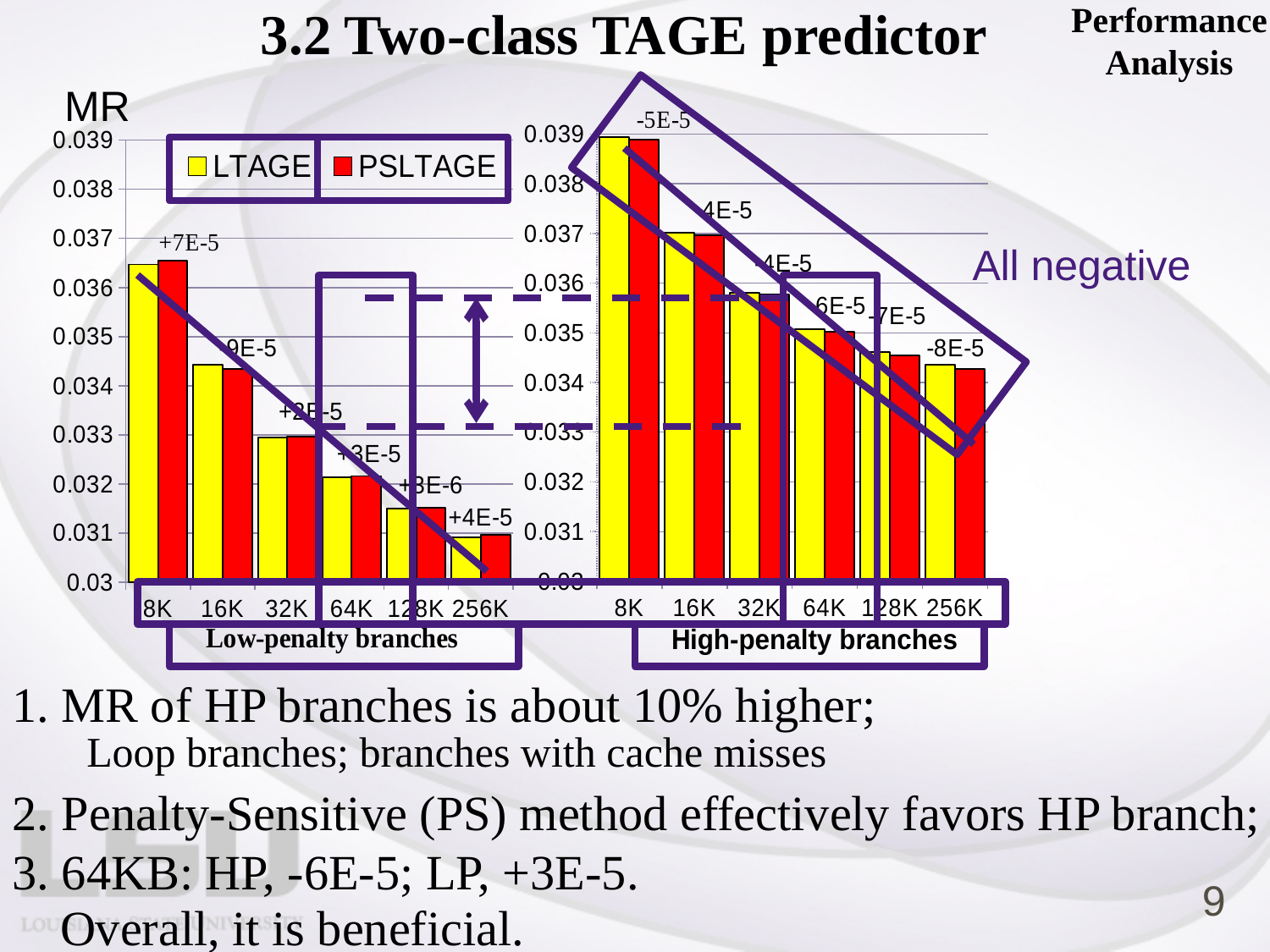
What kind of chart is used for the Low-penalty branches data? bar chart How many series does the legend list? 2 How many predictor size categories are shown on the x axis of the High-penalty branches chart? 6 Which two series are listed in the legend? LTAGE and PSLTAGE In the Low-penalty branches chart, is the LTAGE value for 256K greater or less than 0.031? less In the High-penalty branches chart, which predictor size has the highest MR? 8K In the High-penalty branches chart, do the MR values rise or fall as the predictor size increases from 8K to 256K? fall In the Low-penalty branches chart, which predictor size has the lowest MR? 256K In the High-penalty branches chart, is the LTAGE value for 8K greater or less than 0.038? greater In the Low-penalty branches chart, which predictor size has the highest MR? 8K Which is larger: the LTAGE value for 8K in the High-penalty branches chart or the LTAGE value for 8K in the Low-penalty branches chart? High-penalty branches 8K In the Low-penalty branches chart, is the LTAGE value for 8K greater or less than 0.036? greater